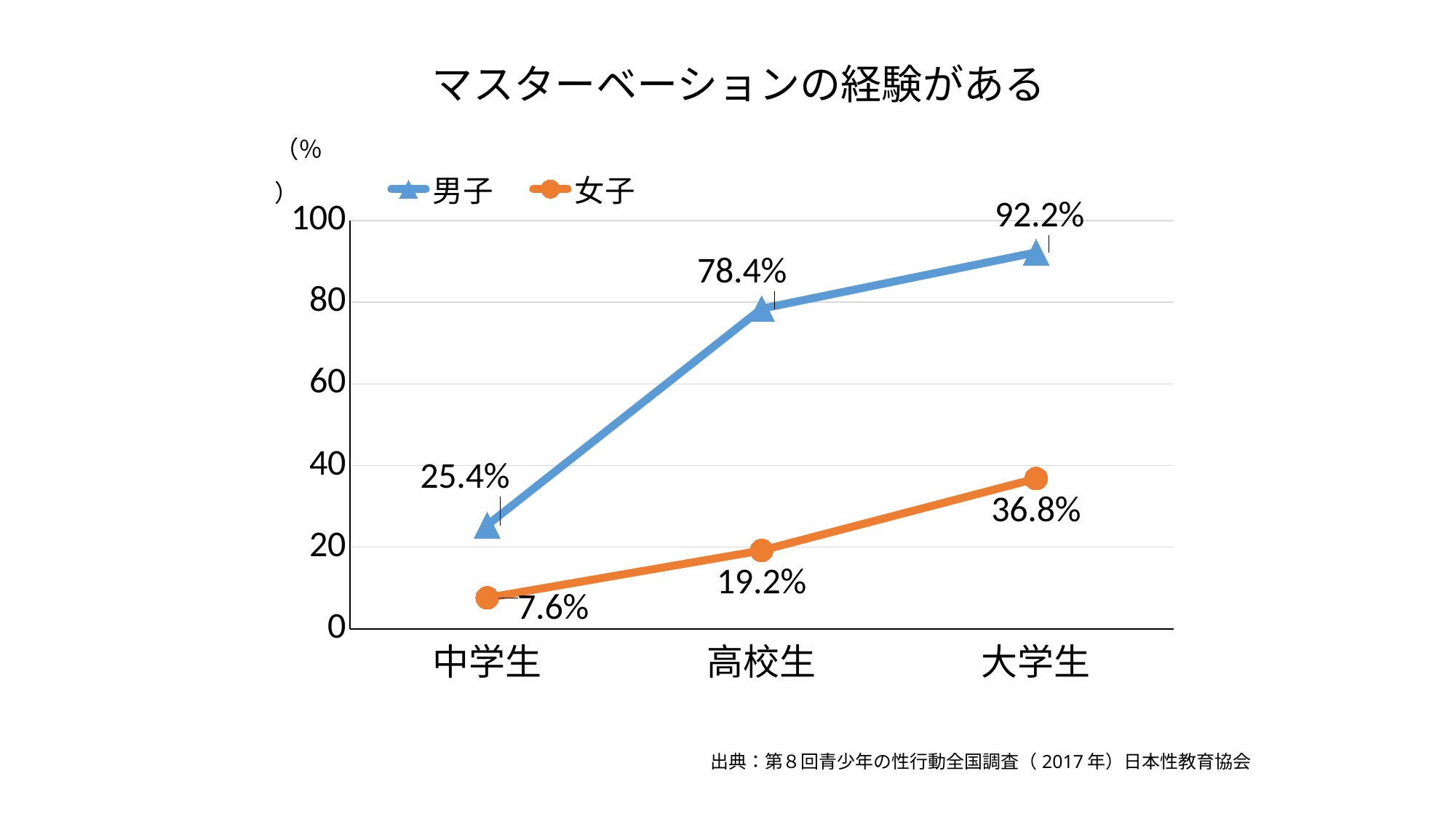
Which is larger at 大学生, 男子 or 女子? 男子 How many series does the legend list? 2 What is the value for 男子 at 大学生? 92.2% What is the value for 女子 at 中学生? 7.6% What is the value for 女子 at 高校生? 19.2% Which category has the lowest value for 男子? 中学生 What kind of chart is this? line chart Is the value for 男子 at 高校生 greater or less than 60? greater What is the difference between 男子 and 女子 at 高校生? 59.2% What is the value for 男子 at 中学生? 25.4% How many categories are shown on the x axis? 3 Which category has the highest value for 女子? 大学生